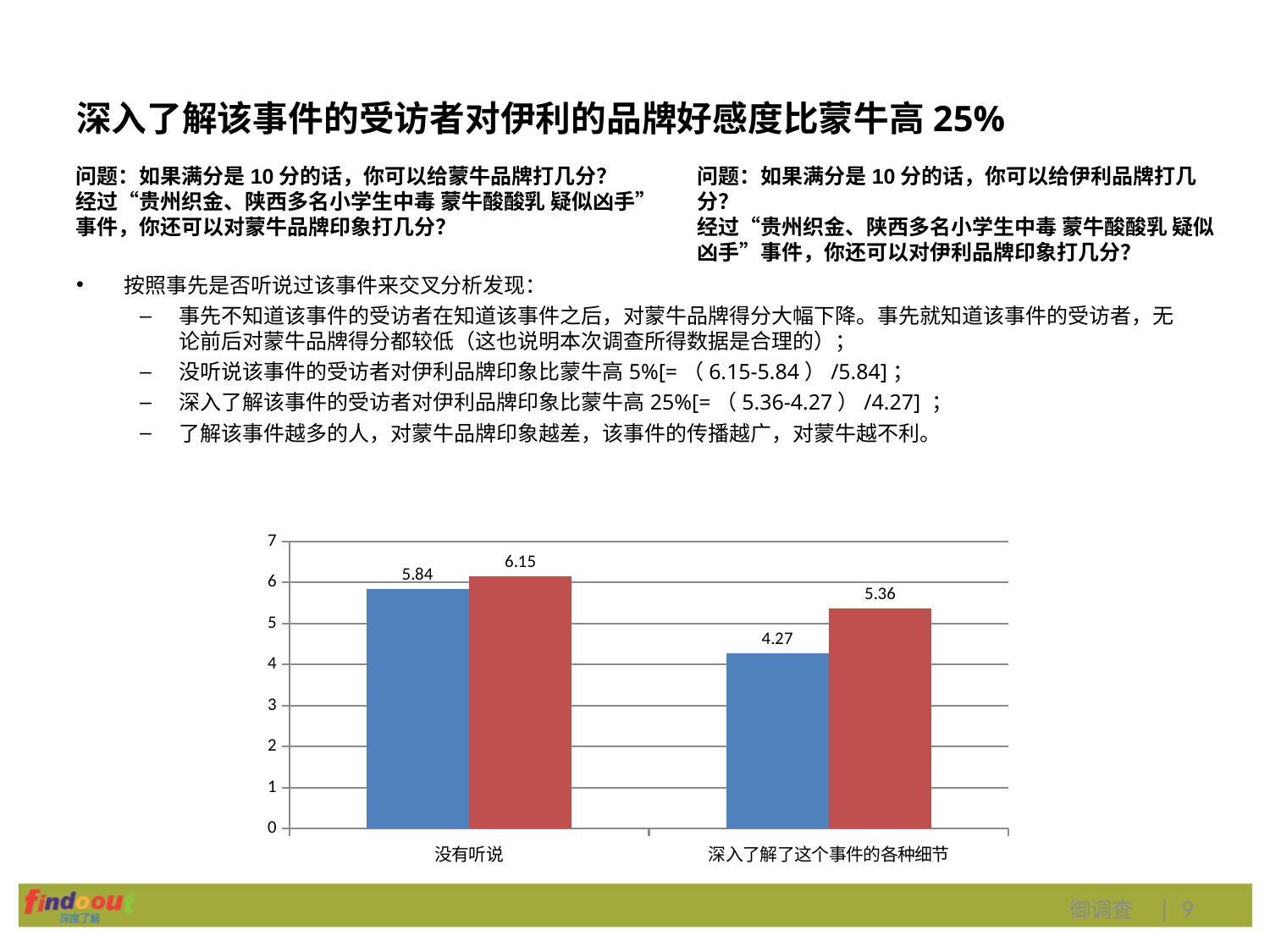
How many categories are shown on the x axis of the chart? 2 Which bar has the lowest value in the chart? The blue bar for 深入了解了这个事件的各种细节 (4.27) What is the value of the red bar for 深入了解了这个事件的各种细节? 5.36 Which bar has the highest value in the chart? The red bar for 没有听说 (6.15) Is the value of the blue bar for 深入了解了这个事件的各种细节 greater or less than 5? less What is the difference between the blue bar for 没有听说 and the blue bar for 深入了解了这个事件的各种细节? 1.57 What is the difference between the red and blue bars for 深入了解了这个事件的各种细节? 1.09 What is the value of the red bar for 没有听说? 6.15 What kind of chart is shown on the slide? Bar chart What is the value of the blue bar for 没有听说? 5.84 For 没有听说, which bar is larger, the blue or the red? Red What is the value of the blue bar for 深入了解了这个事件的各种细节? 4.27